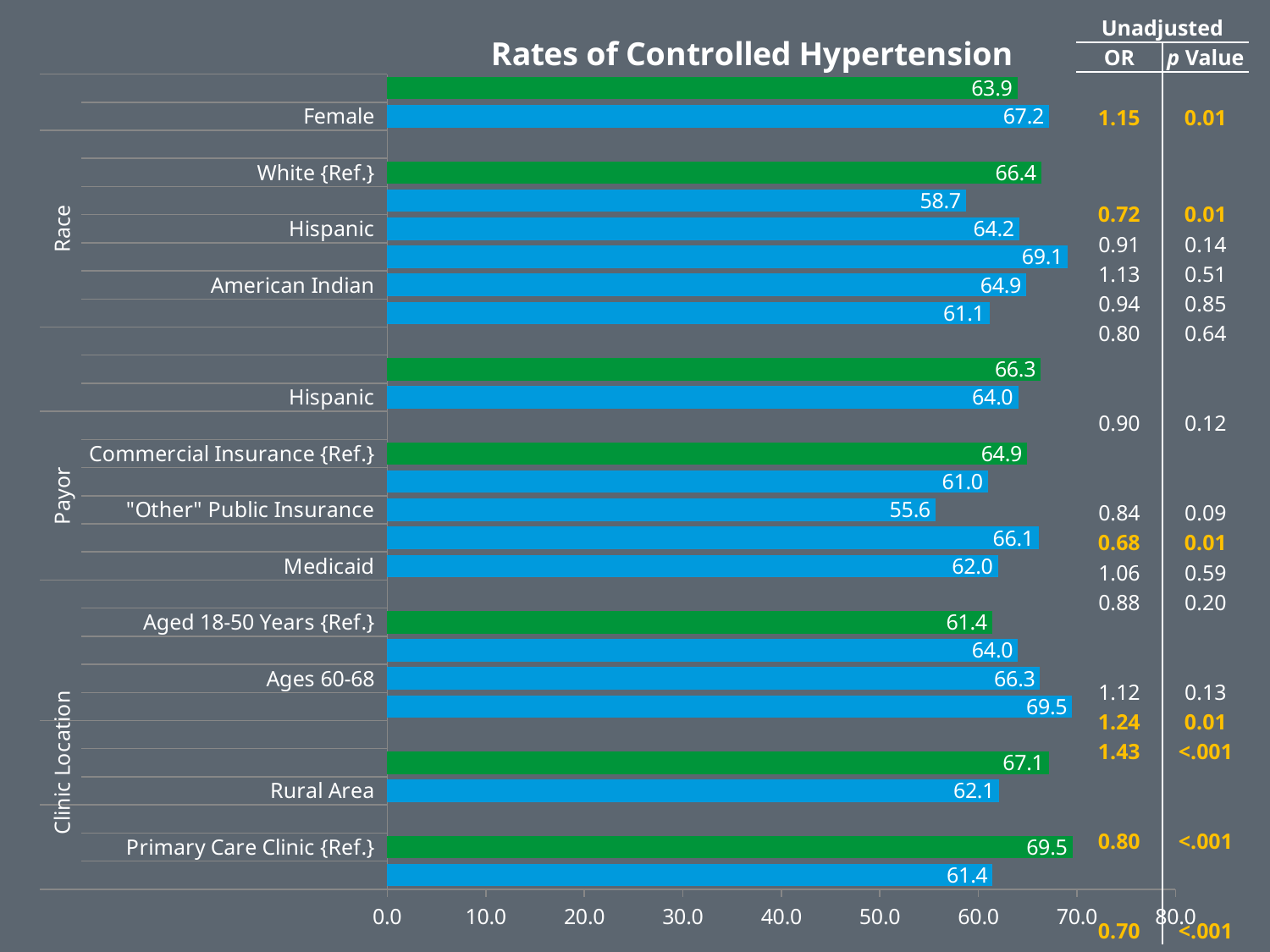
What is the rate of controlled hypertension for Female? 67.2 What is the difference between the rates for Medicaid and "Other" Public Insurance? 6.4 What is the title of the chart? Rates of Controlled Hypertension What is the rate of controlled hypertension for "Other" Public Insurance? 55.6 What is the rate of controlled hypertension for Medicaid? 62.0 What kind of chart is shown on the slide? bar chart Is the value for "Other" Public Insurance greater or less than 60.0? less What is the rate of controlled hypertension for White {Ref.}? 66.4 What is the rate of controlled hypertension for Rural Area? 62.1 Which labeled category has the lowest rate of controlled hypertension? "Other" Public Insurance Which has a higher rate of controlled hypertension, Primary Care Clinic {Ref.} or Rural Area? Primary Care Clinic {Ref.} What is the rate of controlled hypertension for Primary Care Clinic {Ref.}? 69.5